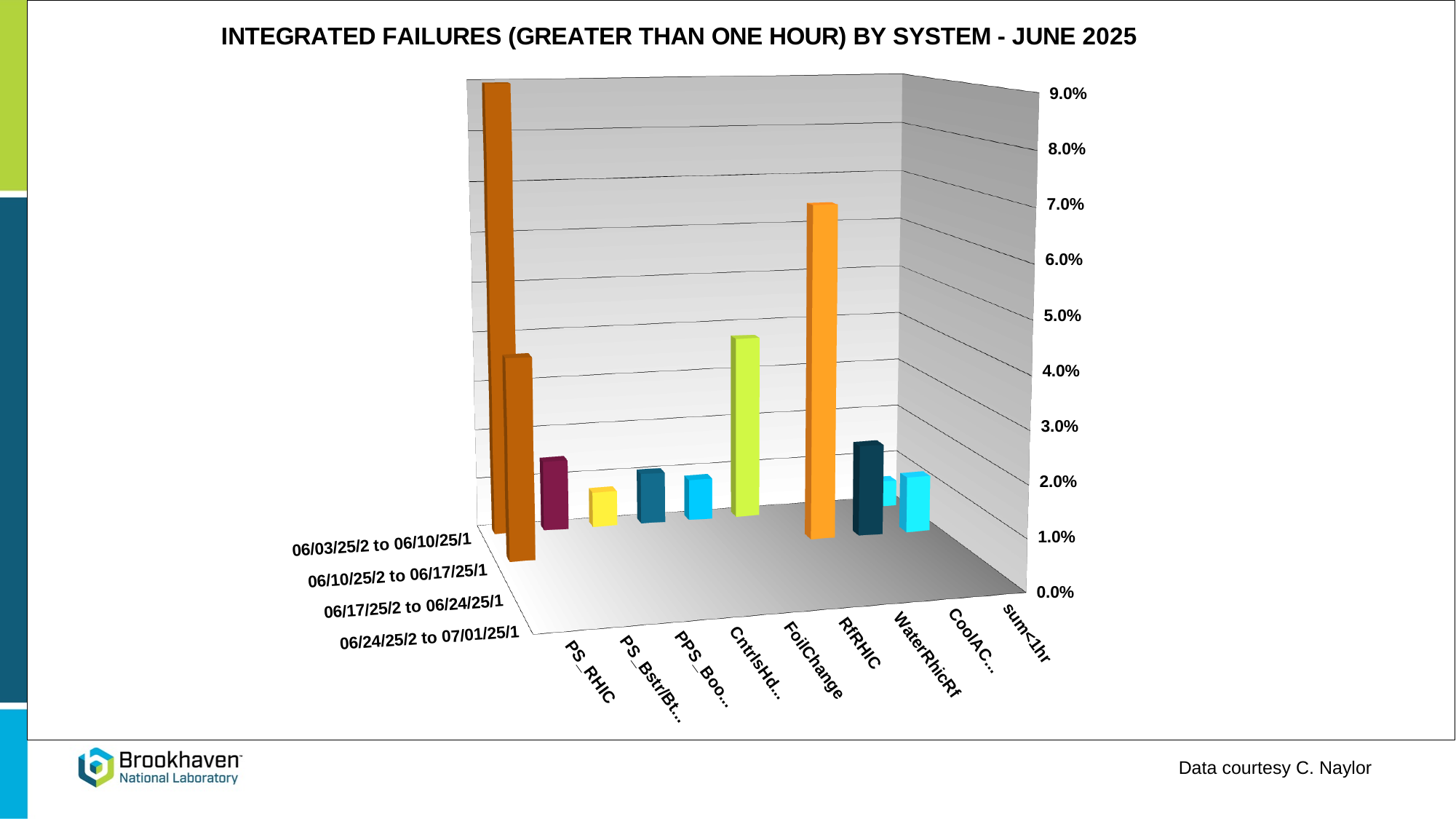
Is the tallest bar for PS_RHIC greater or less than 5.0%? greater Is the tallest bar for sum<1hr greater or less than 4.0%? less How many weekly date ranges are listed along the depth axis of the chart? 4 What is the title of the chart? INTEGRATED FAILURES (GREATER THAN ONE HOUR) BY SYSTEM - JUNE 2025 What is the highest value shown on the vertical axis of the chart? 9.0% What is the first date range listed on the depth axis of the chart? 06/03/25/2 to 06/10/25/1 How many system categories are listed along the horizontal axis of the chart? 9 What kind of chart is shown on the slide? 3D bar chart Which system has the tallest bar in the chart? PS_RHIC Which is taller in the chart: the tallest bar for PS_RHIC or the tallest bar for sum<1hr? PS_RHIC